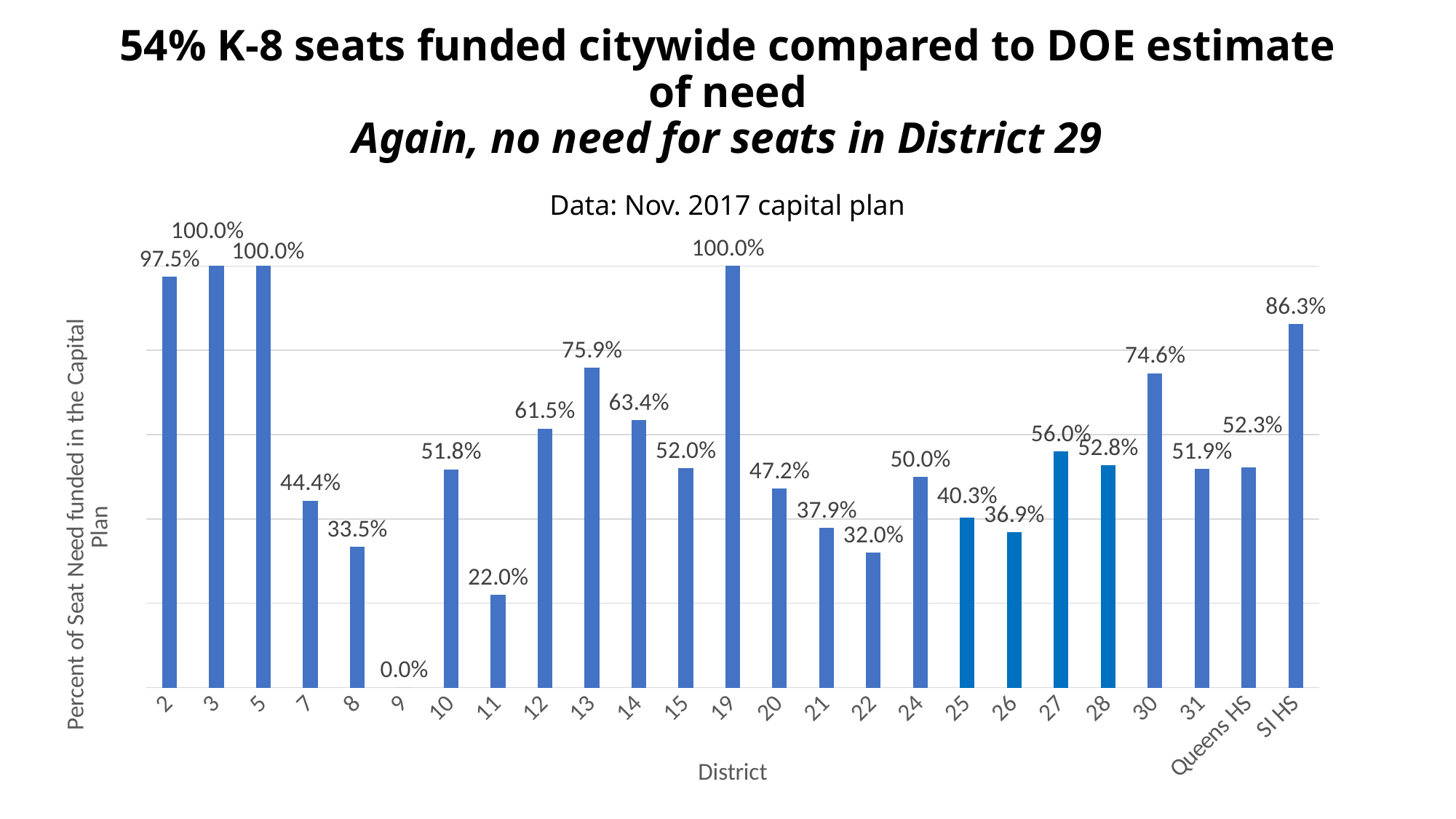
What kind of chart is shown? Bar chart What is the value for SI HS? 86.3% What is the value for District 7? 44.4% What is the difference between the values for District 30 and District 31? 22.7% Which is larger, the value for District 27 or District 28? District 27 Which is larger, the value for District 22 or District 26? District 26 What is the value for Queens HS? 52.3% What is the value for District 11? 22.0% Which district has the lowest value? 9 What is the difference between the values for District 13 and District 12? 14.4% What is the x-axis title of the chart? District How many categories are shown on the x axis? 25